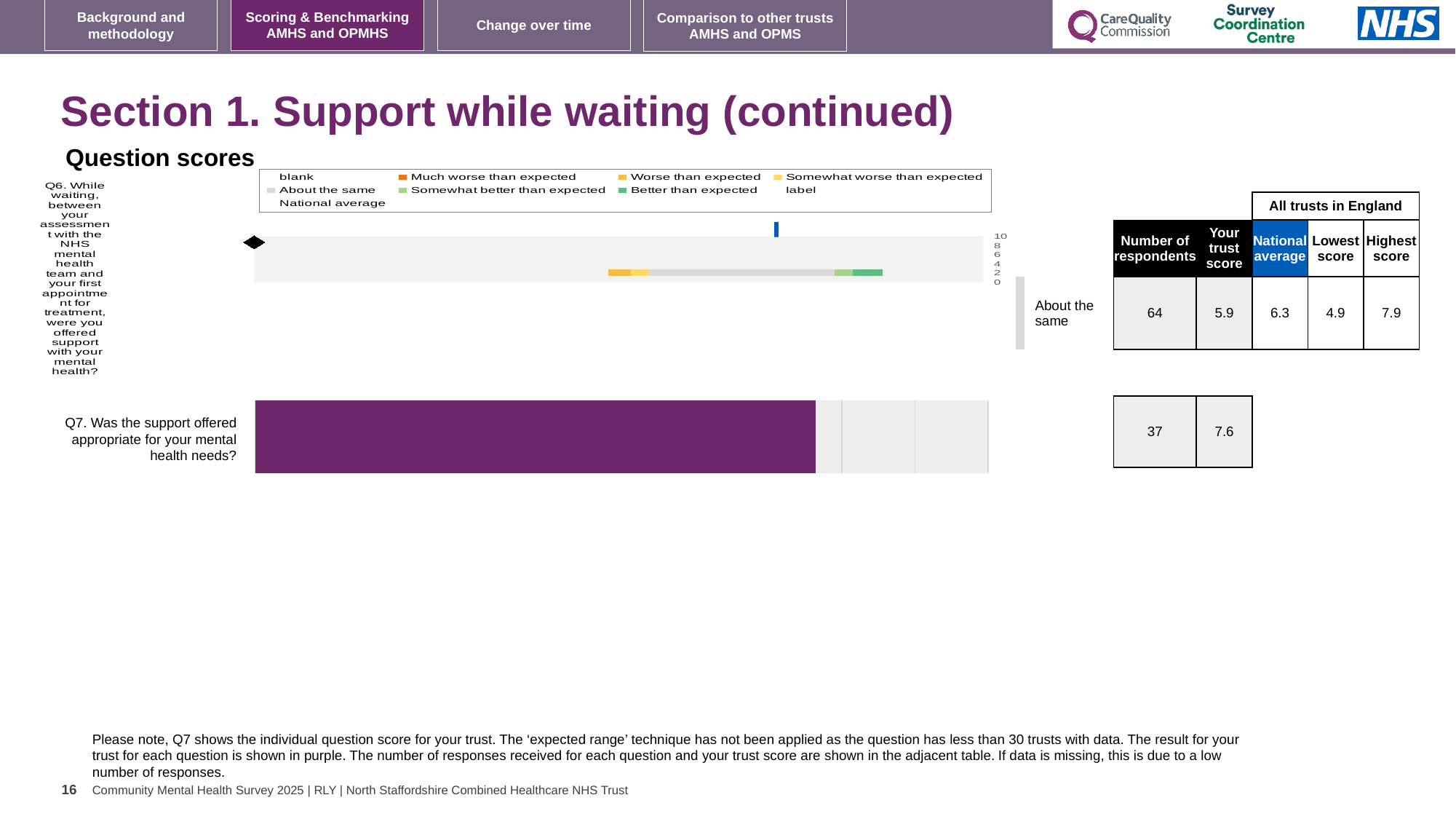
What is the difference between the trust scores for Q7 and Q6? 1.7 What is the highest score among all trusts in England for Q6? 7.9 What expected-range category is shown next to the Q6 bar? About the same How many respondents answered Q7 (was the support offered appropriate for your mental health needs)? 37 What is the national average score for Q6? 6.3 Is the Q7 bar greater or less than 6 on the score axis? greater What is the lowest score among all trusts in England for Q6? 4.9 Which question has the higher trust score, Q6 or Q7? Q7 How many questions are plotted in the question scores chart? 2 What is the trust score for Q7? 7.6 What kind of chart is used to show the question scores on this slide? bar chart What is the trust score for Q6 (support while waiting between assessment and first appointment)? 5.9